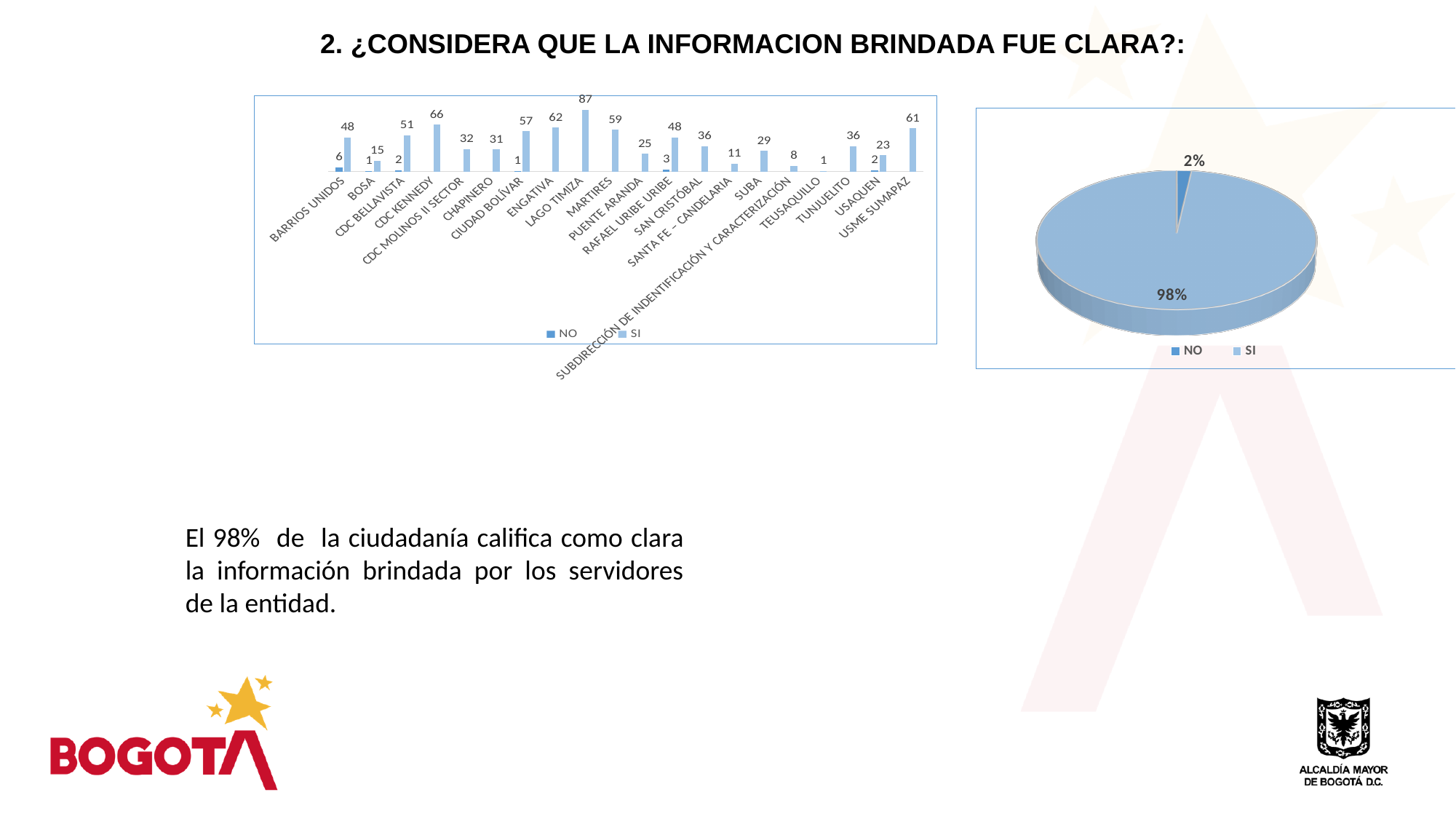
What kind of chart is the chart on the right? Pie chart In the bar chart on the left, what is the difference between the SI values for ENGATIVA and MARTIRES? 3 In the bar chart on the left, what is the SI value for LAGO TIMIZA? 87 What kind of chart is the chart on the left? Bar chart In the bar chart on the left, which has a larger SI value, USME SUMAPAZ or CIUDAD BOLÍVAR? USME SUMAPAZ In the bar chart on the left, which category has the highest SI value? LAGO TIMIZA How many series does the legend of the bar chart on the left list? 2 How many categories are shown on the x axis of the bar chart on the left? 20 In the bar chart on the left, what is the SI value for CDC KENNEDY? 66 In the bar chart on the left, what is the NO value for BARRIOS UNIDOS? 6 In the pie chart on the right, what share does the SI slice represent? 98% In the bar chart on the left, which category has the lowest SI value? TEUSAQUILLO